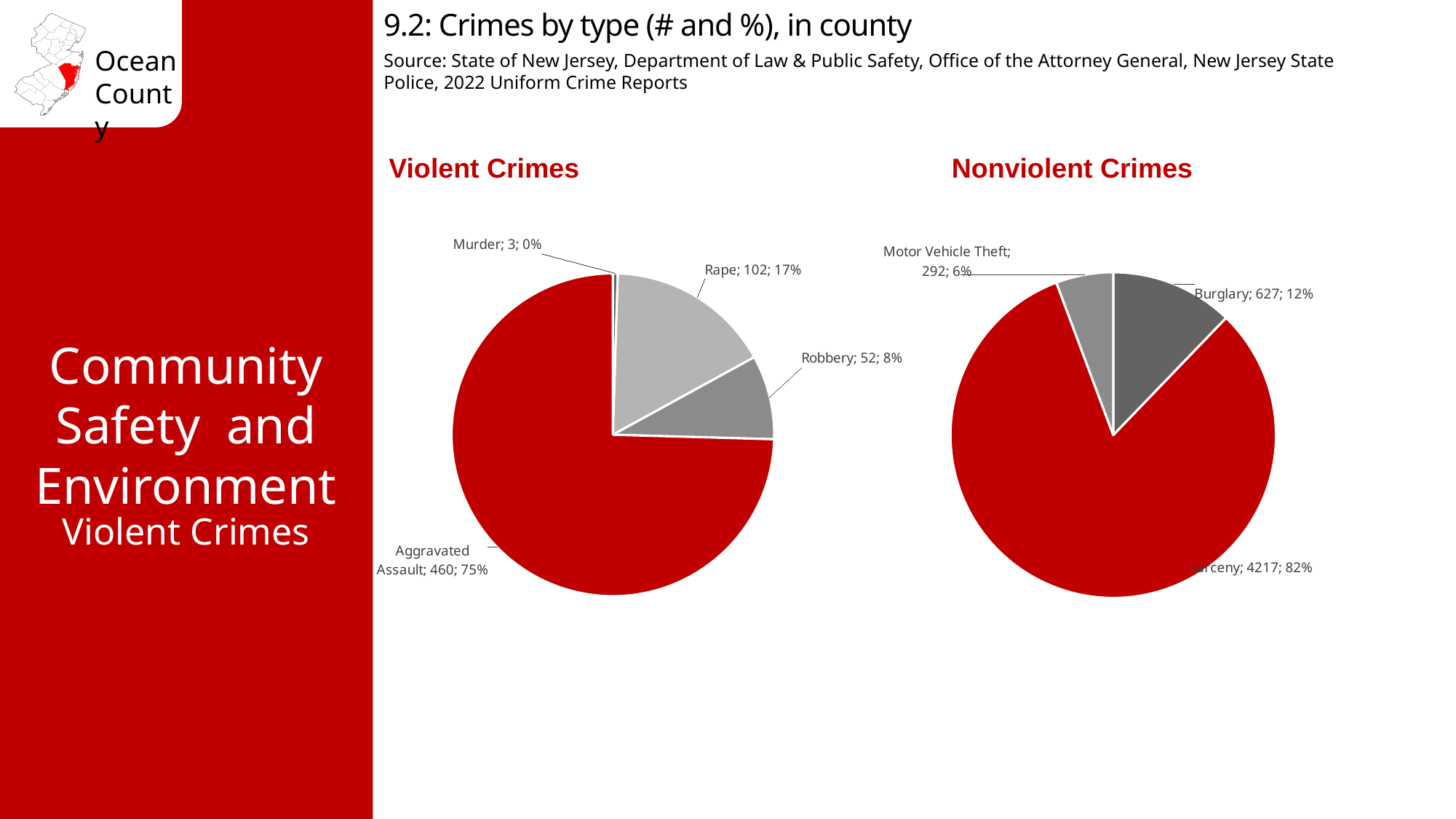
In the Violent Crimes chart, how many crime categories are shown? 4 What type of chart is used for the Nonviolent Crimes data? Pie chart In the Violent Crimes chart, which crime type has the largest slice? Aggravated Assault What is the title of the slide's chart section? 9.2: Crimes by type (# and %), in county In the Violent Crimes chart, how many aggravated assaults are shown? 460 In the Violent Crimes chart, what percentage of violent crimes is rape? 17% In the Violent Crimes chart, what is the difference between the number of rapes and the number of robberies? 50 In the Nonviolent Crimes chart, what is the difference between the number of burglaries and motor vehicle thefts? 335 In the Violent Crimes chart, which crime type has the smallest slice? Murder In the Nonviolent Crimes chart, which is larger: burglary or motor vehicle theft? Burglary In the Nonviolent Crimes chart, what percentage of nonviolent crimes is burglary? 12% In the Nonviolent Crimes chart, how many larcenies are shown? 4217